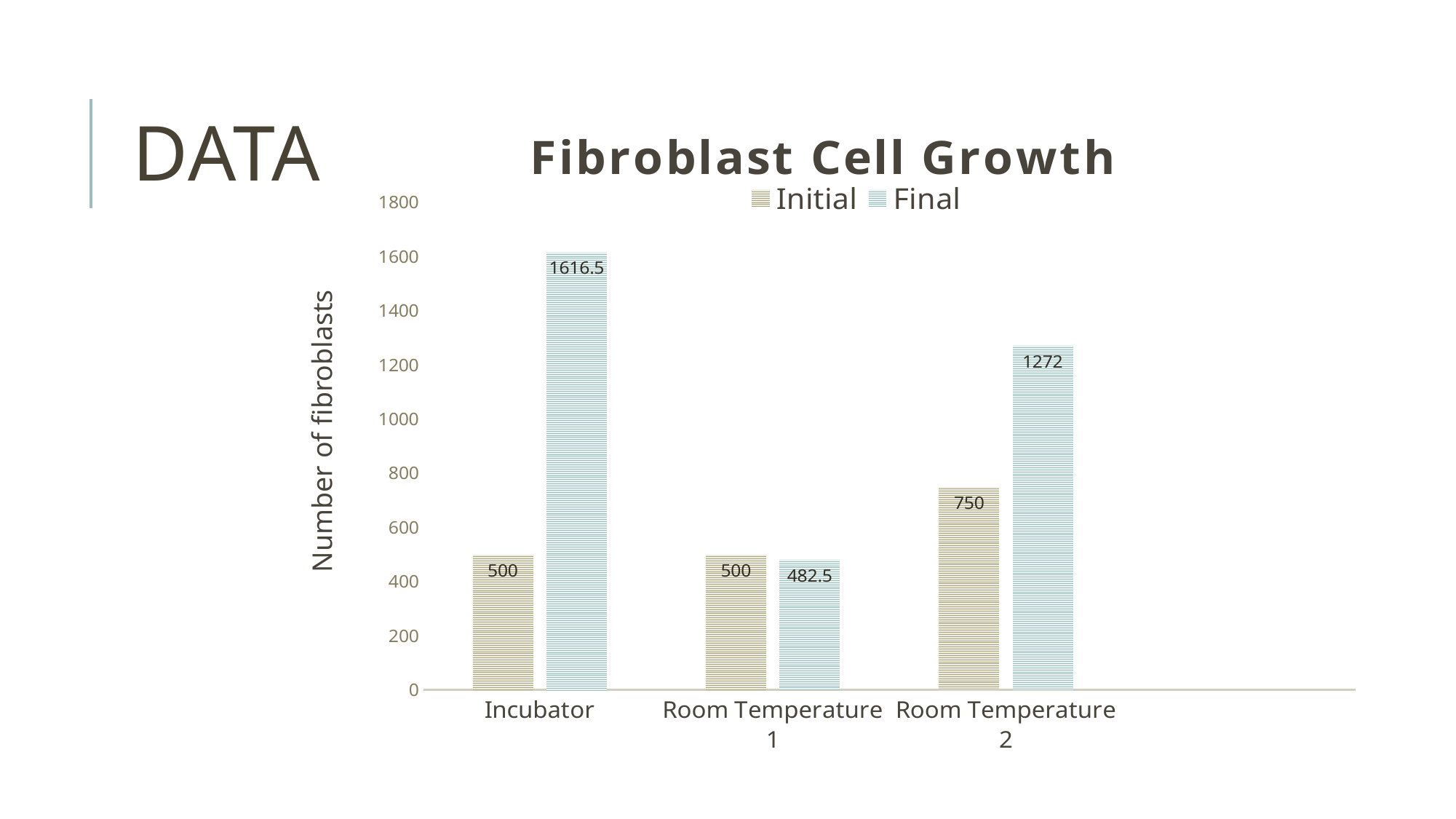
What is the Final value for Incubator? 1616.5 What is the Final value for Room Temperature 1? 482.5 Which category has the lowest Final value? Room Temperature 1 What is the difference between the Final values for Incubator and Room Temperature 2? 344.5 What is the difference between the Final and Initial values for Incubator? 1116.5 What type of chart is shown? Bar chart Which category has the highest Final value? Incubator Which is larger for Room Temperature 1, the Initial value or the Final value? Initial What is the Initial value for Room Temperature 2? 750 How many series does the legend list? 2 Is the Final value for Room Temperature 2 greater or less than 1200? greater How many categories are shown on the x axis? 3